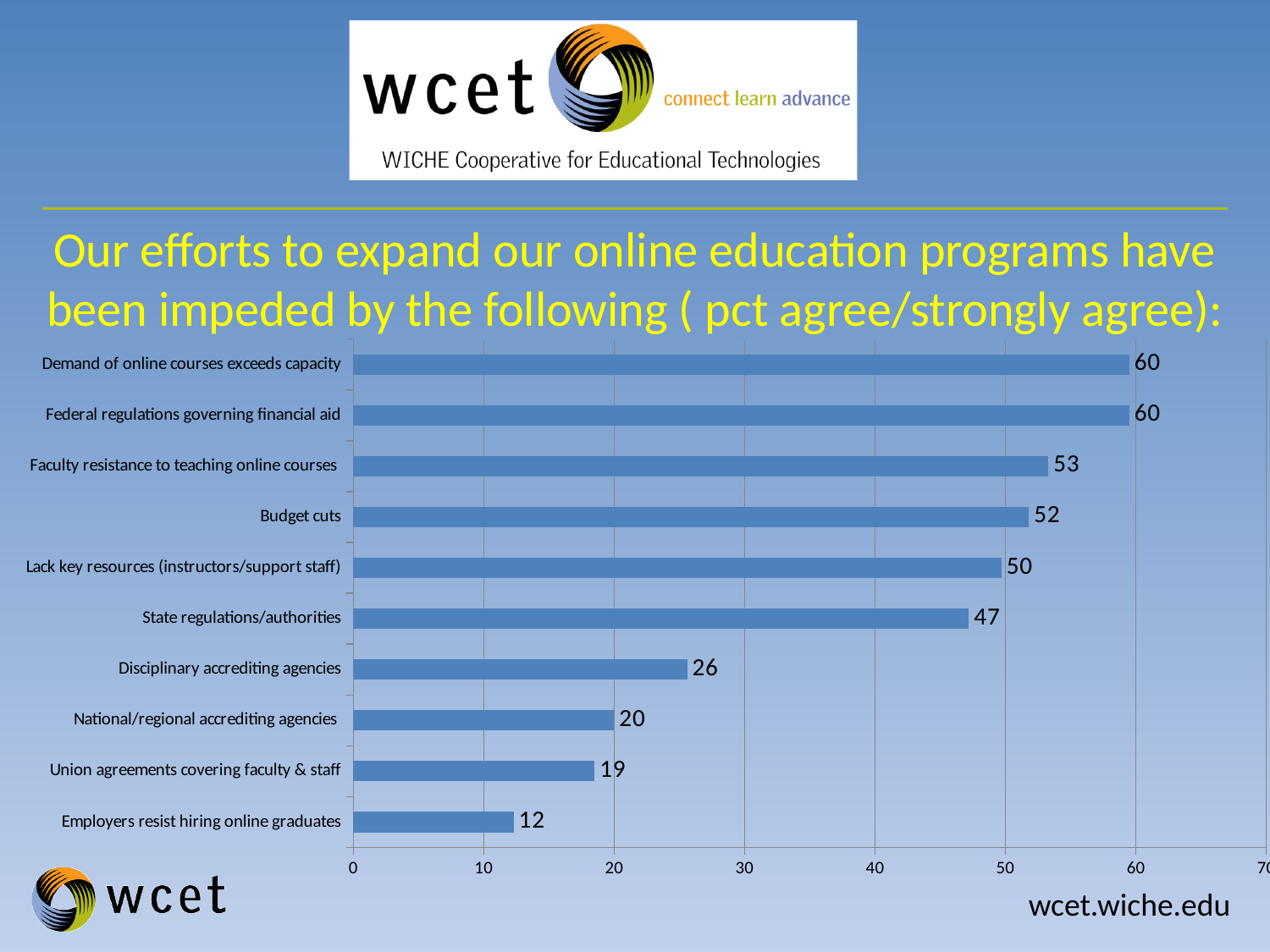
What is the difference between the values for Lack key resources (instructors/support staff) and National/regional accrediting agencies? 30 What is the value for Budget cuts? 52 Which category has the lowest value? Employers resist hiring online graduates What value is shown for Demand of online courses exceeds capacity? 60 What is the value for Union agreements covering faculty & staff? 19 Which is larger, the value for Disciplinary accrediting agencies or the value for National/regional accrediting agencies? Disciplinary accrediting agencies How many categories are shown in the chart? 10 What is the value for State regulations/authorities? 47 What is the highest value shown on the x axis? 70 Is the value for Federal regulations governing financial aid greater or less than 50? greater What kind of chart is shown on the slide? bar chart What is the difference between the values for Faculty resistance to teaching online courses and Disciplinary accrediting agencies? 27